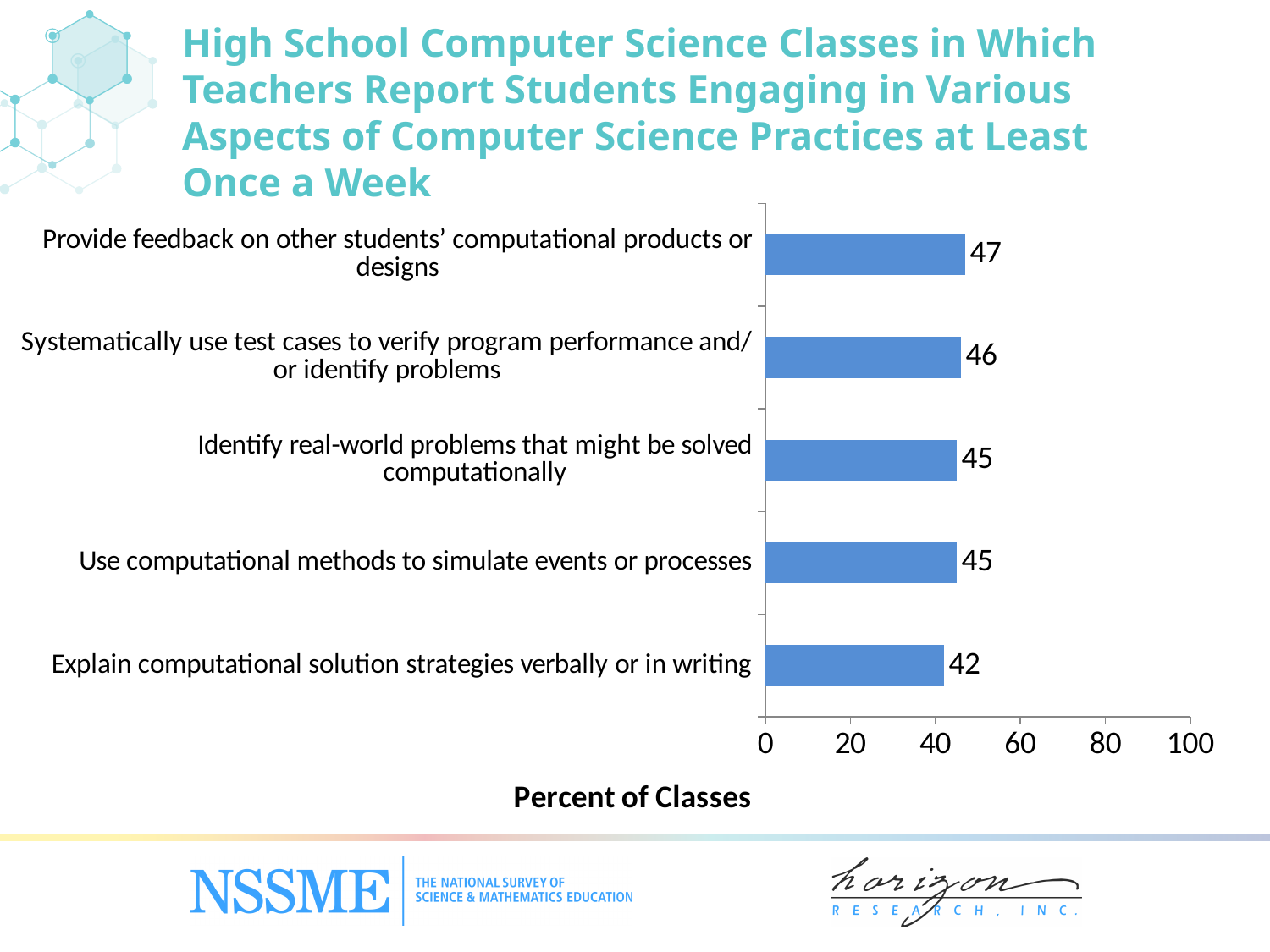
Which practice has the highest percent of classes? Provide feedback on other students' computational products or designs What kind of chart is shown on the slide? bar chart Which is larger: the value for 'Systematically use test cases to verify program performance and/or identify problems' or the value for 'Explain computational solution strategies verbally or in writing'? Systematically use test cases to verify program performance and/or identify problems What is the label of the horizontal axis? Percent of Classes What is the value for 'Explain computational solution strategies verbally or in writing'? 42 Is the value for 'Use computational methods to simulate events or processes' greater or less than 60? less Which practice has the lowest percent of classes? Explain computational solution strategies verbally or in writing What is the difference between the values for 'Provide feedback on other students' computational products or designs' and 'Explain computational solution strategies verbally or in writing'? 5 What percent of classes report students providing feedback on other students' computational products or designs at least once a week? 47 What is the maximum value shown on the horizontal axis? 100 What is the value for 'Systematically use test cases to verify program performance and/or identify problems'? 46 How many practices (categories) are shown in the chart? 5